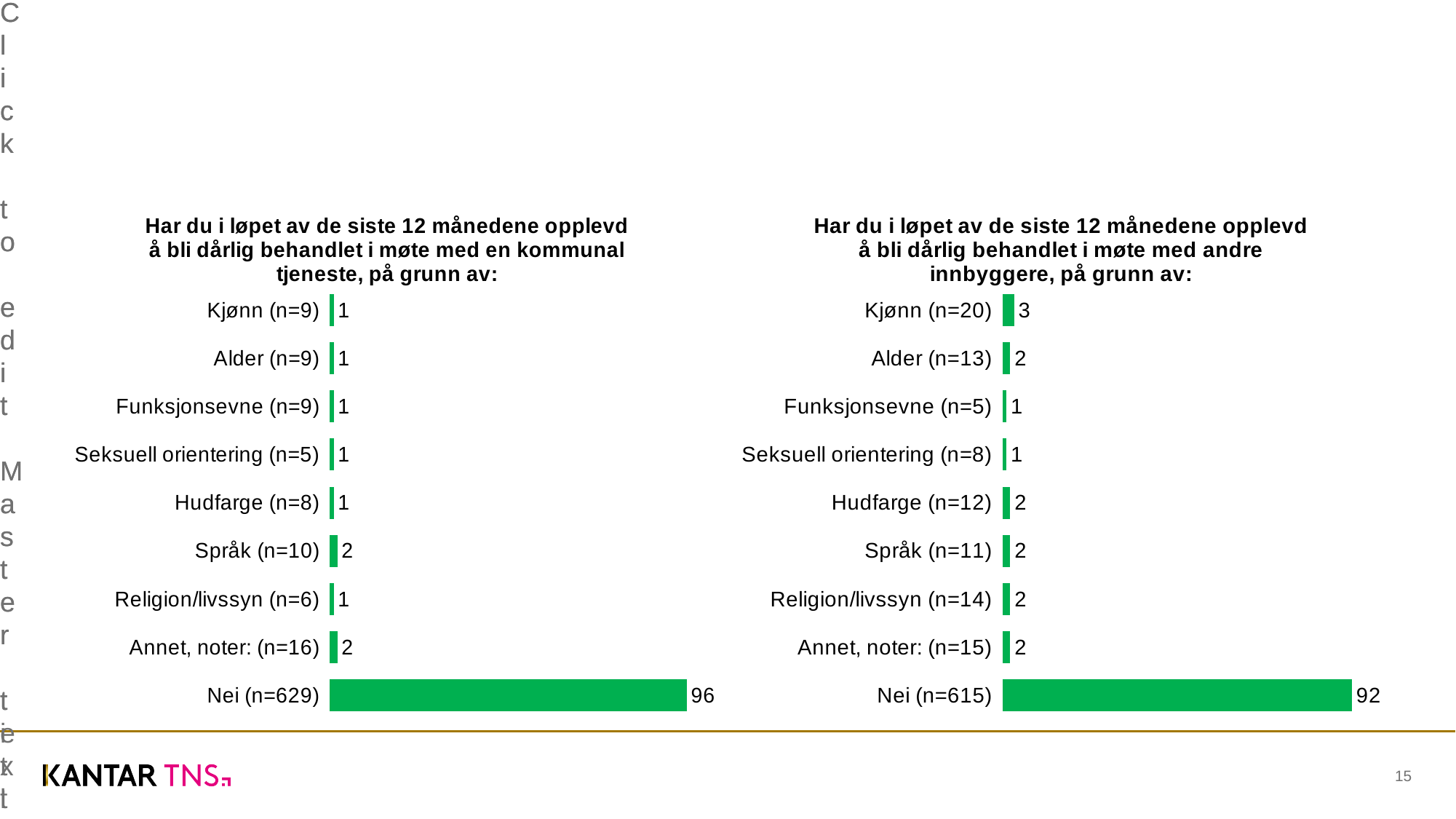
In the left chart (kommunal tjeneste), which category has the highest value? Nei (n=629) In the left chart (kommunal tjeneste), what is the value for Nei (n=629)? 96 What type of chart is used on this slide? Bar chart In the right chart (andre innbyggere), which is larger: Kjønn (n=20) or Alder (n=13)? Kjønn (n=20) In the left chart (kommunal tjeneste), what is the value for Språk (n=10)? 2 In the right chart (andre innbyggere), what is the value for Nei (n=615)? 92 How many categories are shown in the left chart (kommunal tjeneste)? 9 In the right chart (andre innbyggere), what is the difference between Kjønn (n=20) and Funksjonsevne (n=5)? 2 In the right chart (andre innbyggere), which category has the highest value? Nei (n=615) What is the difference between the Nei value in the left chart (96) and the Nei value in the right chart (92)? 4 In the right chart (andre innbyggere), what is the value for Kjønn (n=20)? 3 In the left chart (kommunal tjeneste), what is the value for Annet, noter: (n=16)? 2